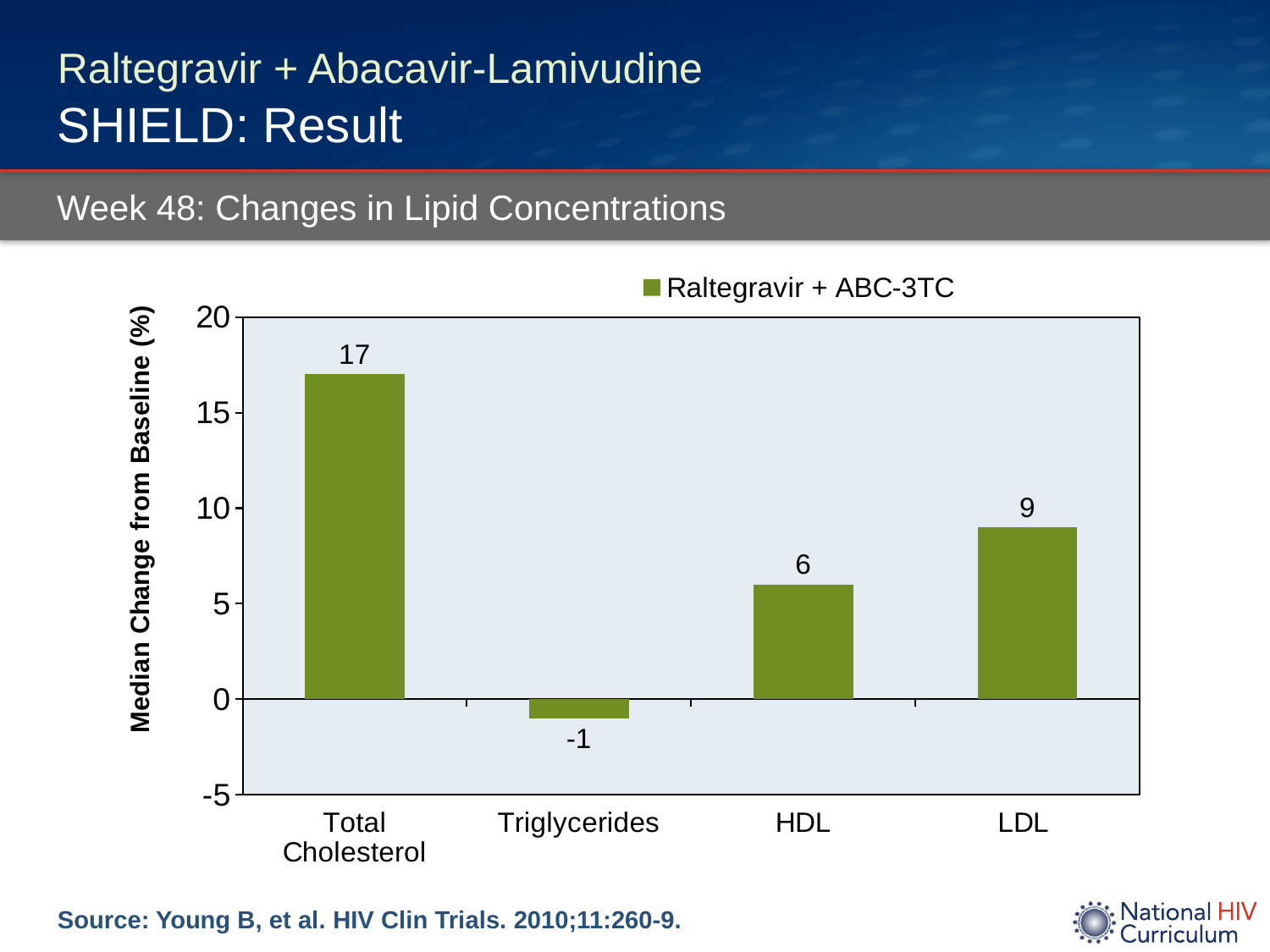
Which lipid category has the lowest median change from baseline? Triglycerides What series does the legend list? Raltegravir + ABC-3TC What type of chart is shown on the slide? Bar chart What is the median change from baseline for LDL? 9 What is the median change from baseline for Total Cholesterol? 17 How many lipid categories are shown on the x axis? 4 Which lipid category has the highest median change from baseline? Total Cholesterol Which has a larger median change from baseline, HDL or LDL? LDL What is the difference between the median change for Total Cholesterol and LDL? 8 What is the median change from baseline for Triglycerides? -1 Is the value for Total Cholesterol greater or less than 15? greater What is the median change from baseline for HDL? 6